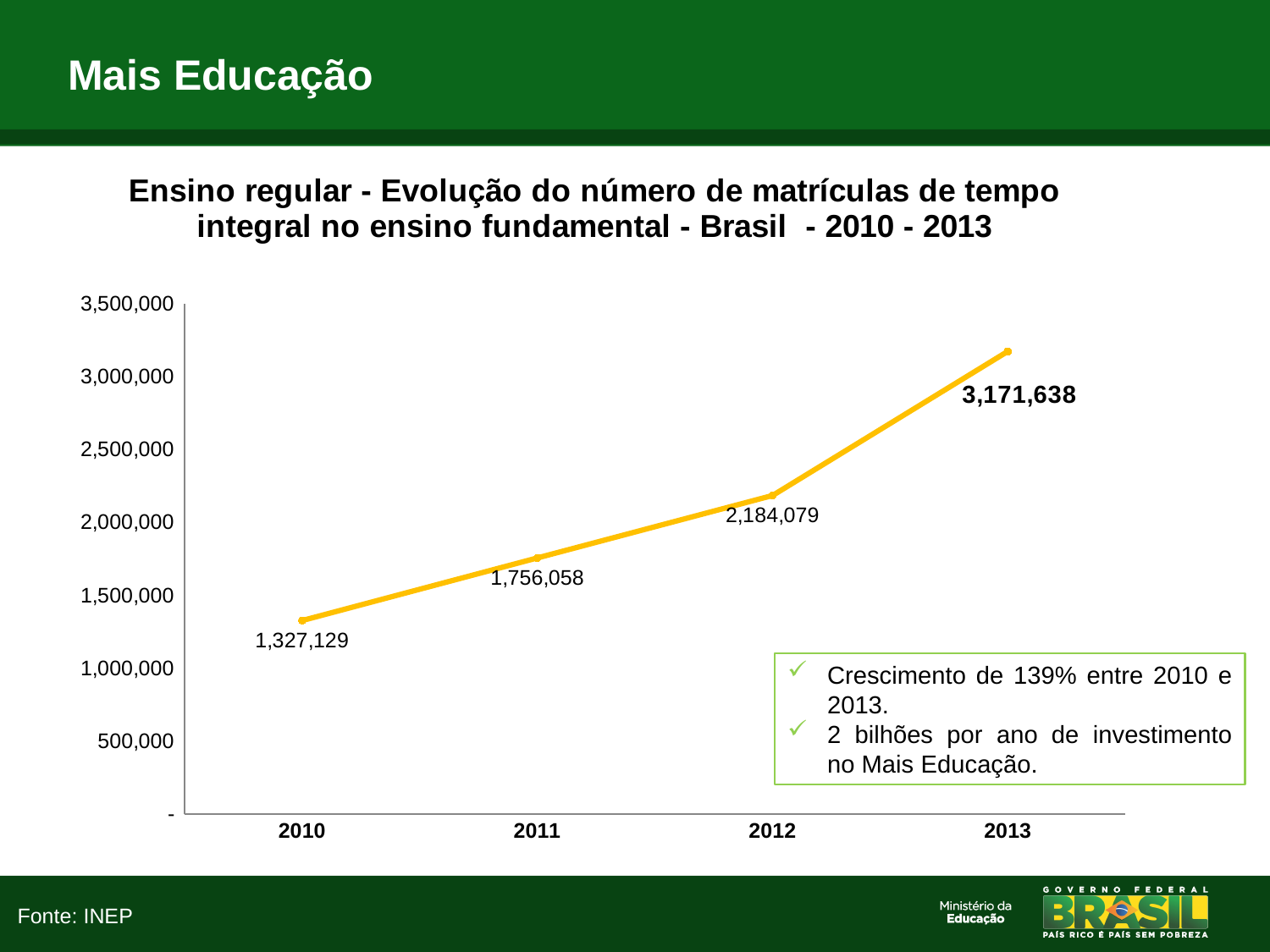
What is the difference between the values for 2013 and 2010? 1,844,509 Which year has a larger value, 2011 or 2012? 2012 Which year has the highest value on the chart? 2013 How many years are plotted on the x axis? 4 Do the values rise or fall from 2010 to 2013? Rise What is the value plotted for 2012? 2,184,079 What is the difference between the values for 2012 and 2011? 428,021 What is the value plotted for 2013? 3,171,638 What is the value plotted for 2011? 1,756,058 What kind of chart is shown on the slide? Line chart What is the number of full-time enrollments shown for 2010? 1,327,129 Which year has the lowest value on the chart? 2010